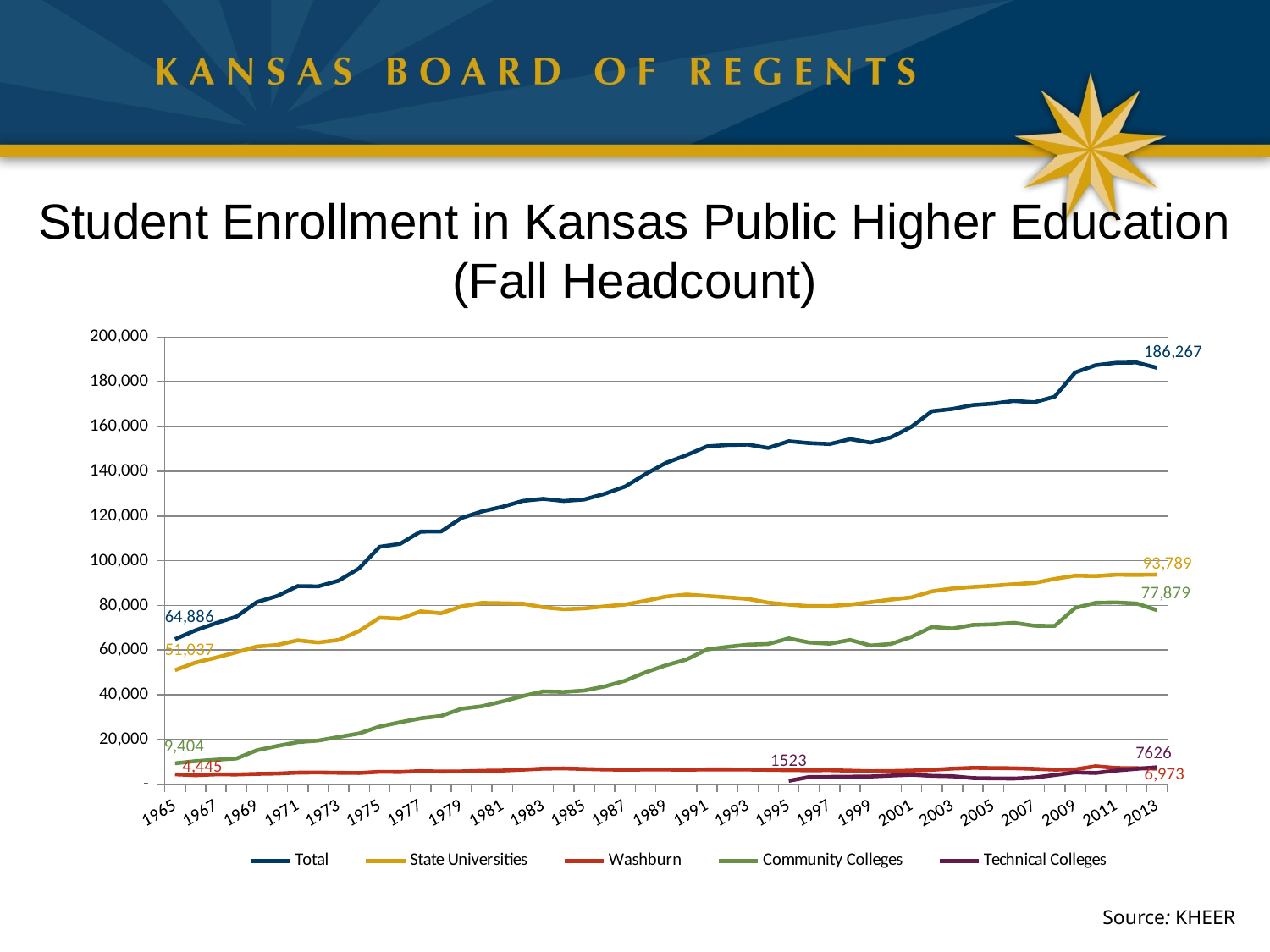
How many series does the legend list? 5 What is the Community Colleges enrollment value labeled for 2013? 77,879 In 2013, which is larger: the Technical Colleges value (7626) or the Washburn value (6,973)? Technical Colleges What is the Total enrollment value labeled for 2013? 186,267 Which series has the highest value in 2013? Total What is the Community Colleges enrollment value labeled in 1965? 9,404 What is the Total enrollment value labeled at the start of the series in 1965? 64,886 What is the difference between the Total enrollment labeled for 2013 and the Total enrollment labeled for 1965? 121,381 Does the Total enrollment line generally rise or fall from 1965 to 2013? rise What kind of chart is shown on the slide? line chart Is the State Universities value in 1985 greater or less than 100,000? less What is the State Universities enrollment value labeled for 2013? 93,789